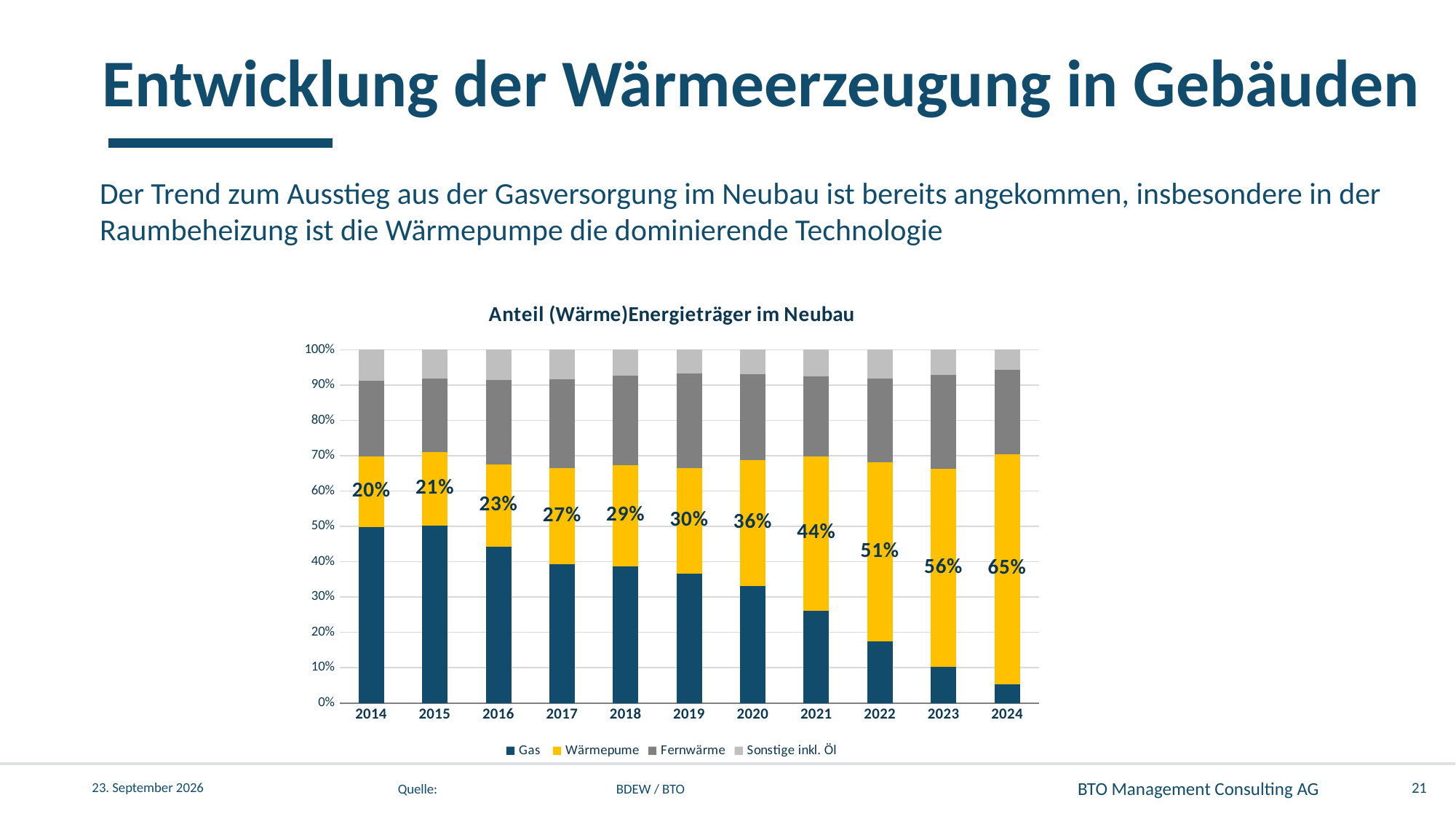
What is the Wärmepumpe share in 2021? 44% What type of chart is shown on the slide? stacked bar chart What is the Wärmepumpe share in 2024? 65% In which year is the Wärmepumpe share highest? 2024 In which year is the Wärmepumpe share lowest? 2014 How many years are shown on the x axis? 11 What is the Wärmepumpe share in 2014? 20% How many series does the legend list? 4 What is the title of the chart? Anteil (Wärme)Energieträger im Neubau Does the Wärmepumpe share rise or fall from 2014 to 2024? rise By how many percentage points did the Wärmepumpe share increase from 2014 to 2024? 45 percentage points Is the Gas share in 2024 greater or less than 10%? less